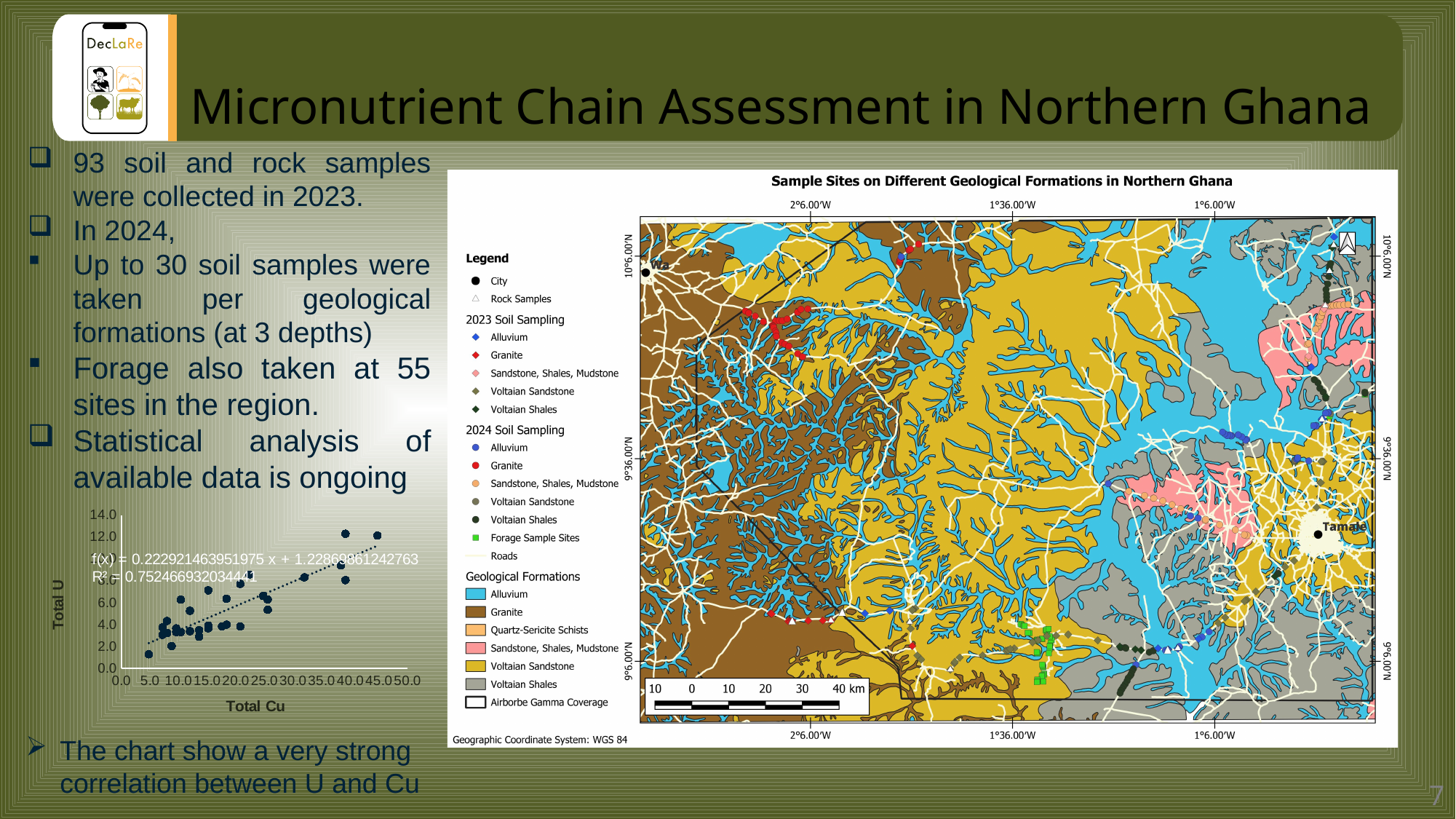
In the scatter chart, what is the label of the x axis? Total Cu What is the intercept of the trendline equation printed on the scatter chart? 1.22869861242763 In the scatter chart, what is the label of the y axis? Total U In the scatter chart, is the lowest plotted Total U value greater or less than 4.0? less What kind of chart is the Total U versus Total Cu chart on the left of the slide? scatter chart In the scatter chart, is the highest plotted Total U value greater or less than 10.0? greater In the scatter chart, are the points with the highest Total U values found at Total Cu values greater or less than 35.0? greater In the scatter chart, do the Total U values generally rise or fall as Total Cu increases? rise What R² value is printed on the scatter chart? 0.752466932034441 What is the slope of the trendline equation printed on the scatter chart? 0.222921463951975 What is the highest tick value shown on the x axis of the scatter chart? 50.0 What is the highest tick value shown on the y axis of the scatter chart? 14.0